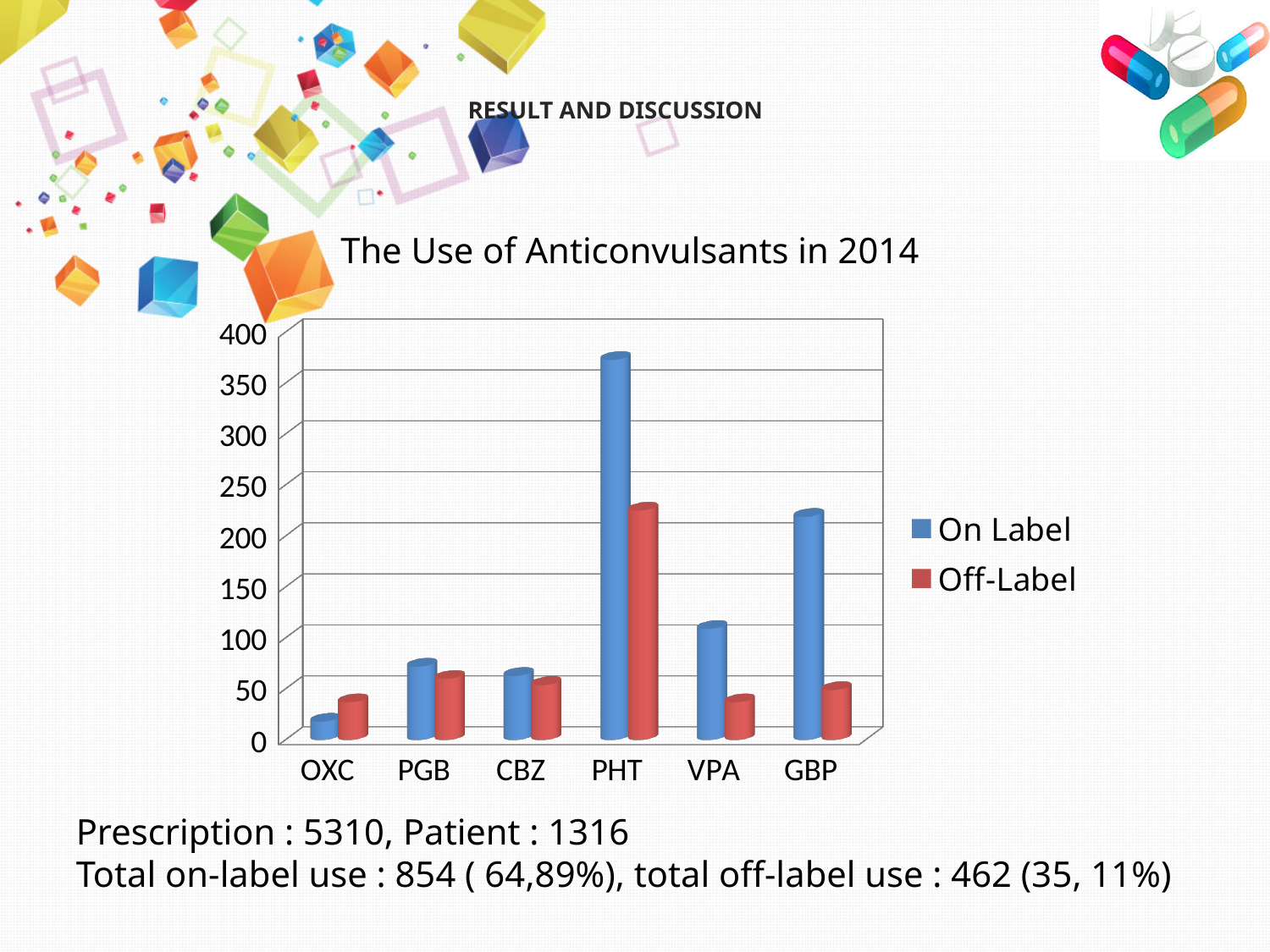
Is the Off-Label value for PHT greater or less than 200? greater Is the On Label value for GBP greater or less than 200? greater Which drug has the lowest On Label value? OXC For OXC, which is larger: the On Label value or the Off-Label value? Off-Label Which drug has the highest Off-Label value? PHT Is the On Label value for PHT greater or less than 350? greater Which drug has the highest On Label value? PHT How many drug categories are shown on the x axis? 6 What kind of chart is shown on the slide? bar chart What is the title of the chart? The Use of Anticonvulsants in 2014 How many series does the legend list? 2